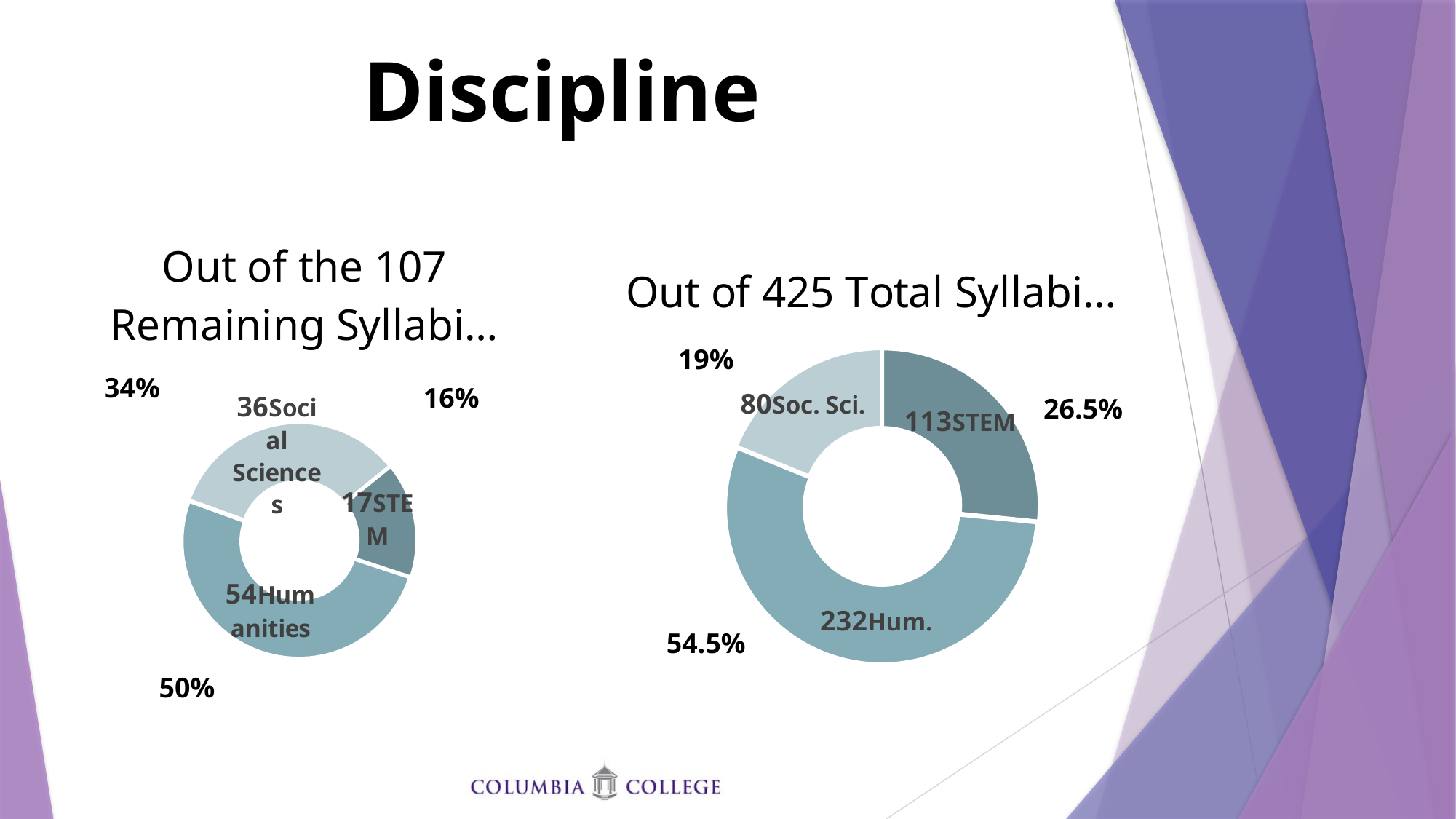
In the chart titled "Out of the 107 Remaining Syllabi...", what percentage share does STEM have? 16% In the chart titled "Out of 425 Total Syllabi...", what is the difference between the Hum. count and the STEM count? 119 What type of chart is the chart titled "Out of the 107 Remaining Syllabi..."? Doughnut chart In the chart titled "Out of 425 Total Syllabi...", which is larger, the STEM count or the Soc. Sci. count? STEM In the chart titled "Out of 425 Total Syllabi...", what percentage share does Hum. have? 54.5% In the chart titled "Out of the 107 Remaining Syllabi...", what is the difference between the Humanities count and the Social Sciences count? 18 In the chart titled "Out of the 107 Remaining Syllabi...", which discipline has the largest slice? Humanities In the chart titled "Out of the 107 Remaining Syllabi...", which discipline has the smallest slice? STEM In the chart titled "Out of the 107 Remaining Syllabi...", how many syllabi are Humanities? 54 In the chart titled "Out of 425 Total Syllabi...", which discipline has the smallest slice? Soc. Sci. How many slices does the chart titled "Out of 425 Total Syllabi..." have? 3 In the chart titled "Out of 425 Total Syllabi...", how many syllabi are STEM? 113